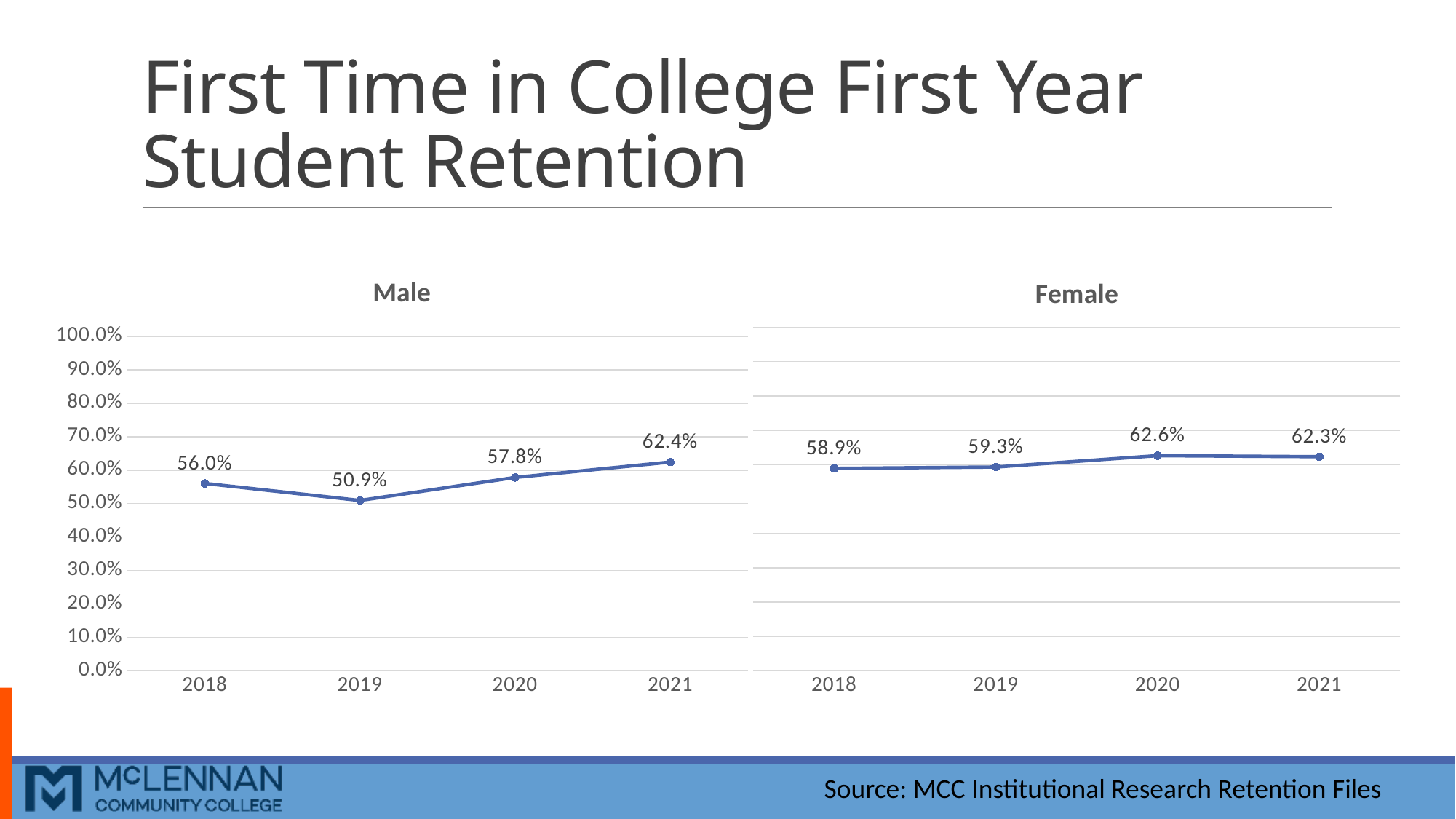
In the Male chart, which year has the lowest retention value? 2019 In the Male chart, which year has the highest retention value? 2021 In the Female chart, what is the retention value for 2018? 58.9% In the Female chart, which year has the lowest retention value? 2018 Which is larger: the Male value for 2018 or the Female value for 2018? Female (58.9%) How many years are plotted in the Male chart? 4 In the Male chart, what is the retention value for 2021? 62.4% In the Male chart, what is the difference between the 2021 and 2018 values? 6.4% What kind of chart is the Female chart? Line chart In the Male chart, what is the retention value for 2019? 50.9% In the Female chart, what is the retention value for 2020? 62.6% In the Female chart, what is the difference between the 2020 and 2019 values? 3.3%